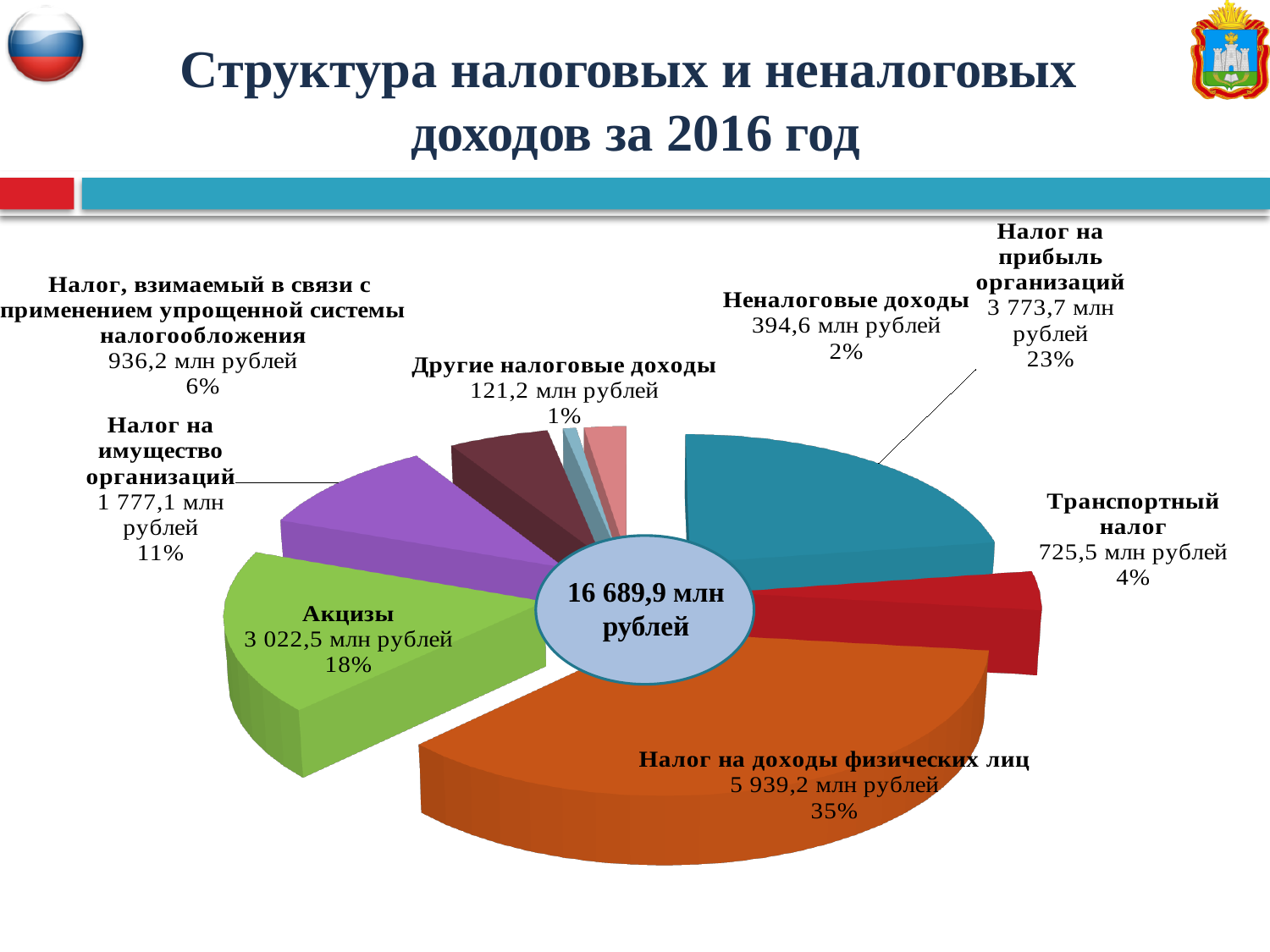
What share of the pie does Налог на прибыль организаций represent? 23% What total value is shown in the centre of the pie chart? 16 689,9 млн рублей What is the title of the slide containing the chart? Структура налоговых и неналоговых доходов за 2016 год How many categories (slices) does the pie chart show? 8 Which category has the largest share of the pie? Налог на доходы физических лиц Which is larger: Транспортный налог or Неналоговые доходы? Транспортный налог Which category has the smallest share of the pie? Другие налоговые доходы What is the difference in percentage points between the shares of Налог на доходы физических лиц and Акцизы? 17% What kind of chart is shown on the slide? Pie chart What share of the pie does Налог на имущество организаций represent? 11% What is the value for Налог на доходы физических лиц? 5 939,2 млн рублей What is the value for Акцизы? 3 022,5 млн рублей